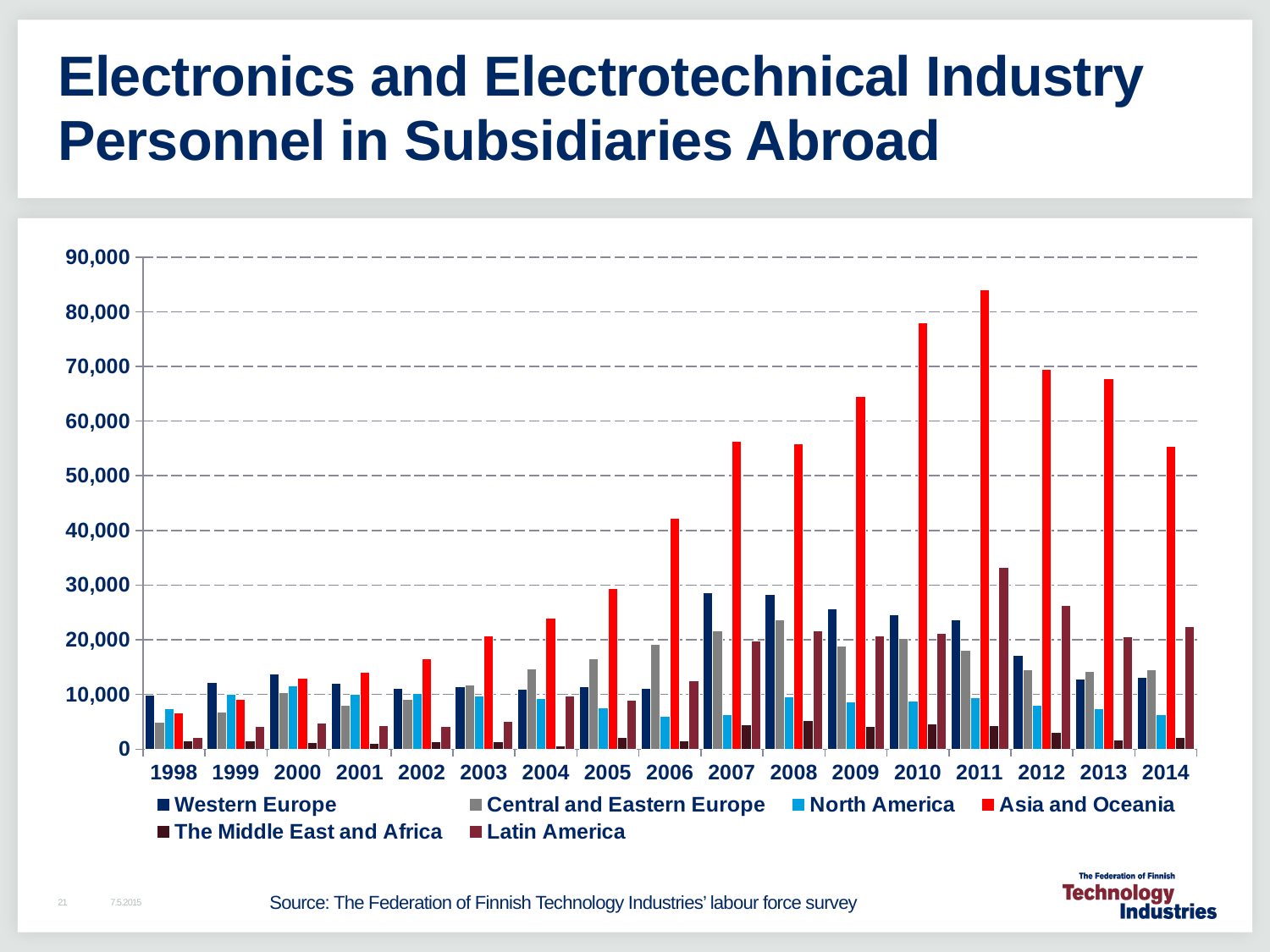
How many years are shown on the x axis? 17 Is the value for Asia and Oceania in 2010 greater or less than 70,000? greater How many series does the legend list? 6 Is the value for Latin America in 2011 greater or less than 30,000? greater In which year is the Asia and Oceania value lowest? 1998 Is the value for Asia and Oceania in 2011 greater or less than 80,000? greater Does the Asia and Oceania series rise or fall from 1998 to 2011? rise In 2011, which is larger: Western Europe or Latin America? Latin America In which year is the Asia and Oceania value highest? 2011 In 2014, which is larger: Asia and Oceania or Latin America? Asia and Oceania What kind of chart is shown on the slide? bar chart